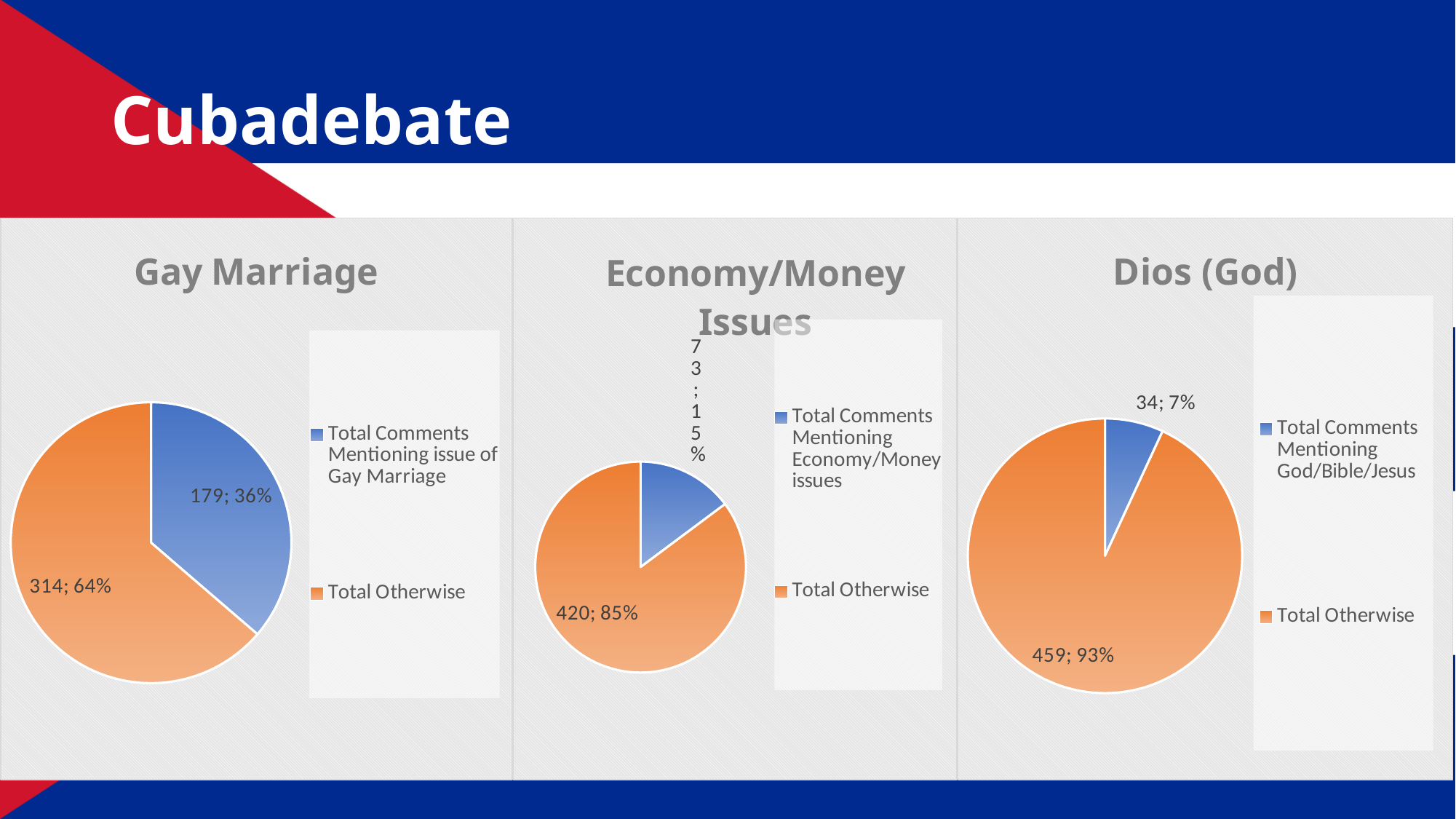
What kind of chart is the "Gay Marriage" chart? pie chart In the "Dios (God)" chart, how many comments mention God/Bible/Jesus? 34 In the "Gay Marriage" chart, how many comments mention the issue of Gay Marriage? 179 In the "Dios (God)" chart, what share of the pie is "Total Otherwise"? 93% In the "Dios (God)" chart, which slice is larger: "Total Comments Mentioning God/Bible/Jesus" or "Total Otherwise"? Total Otherwise In the "Economy/Money Issues" chart, what share of the pie is "Total Comments Mentioning Economy/Money issues"? 15% In the "Gay Marriage" chart, what share of the pie is "Total Otherwise"? 64% In the "Gay Marriage" chart, what is the difference between "Total Otherwise" and "Total Comments Mentioning issue of Gay Marriage"? 135 How many slices does the "Dios (God)" pie chart have? 2 In the "Economy/Money Issues" chart, what is the total of the two slices? 493 How many pie charts are shown on the slide? 3 In the "Economy/Money Issues" chart, what is the value for "Total Otherwise"? 420